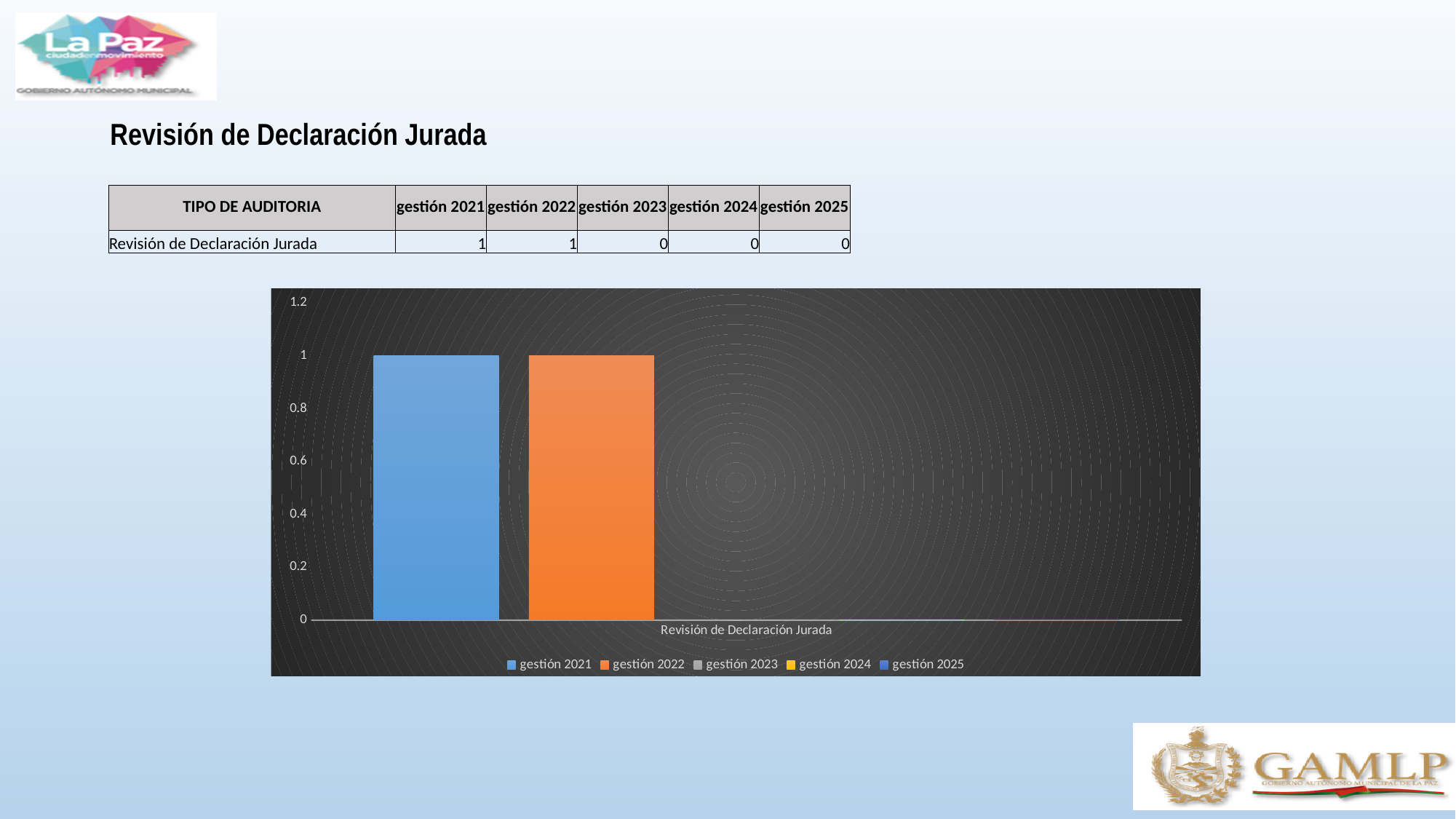
What is the category label shown on the x axis of the chart? Revisión de Declaración Jurada Is the value for gestión 2021 greater or less than 0.8? greater What is the difference between the values for gestión 2021 and gestión 2022? 0 How many series does the chart legend list? 5 How many categories are shown on the x axis of the chart? 1 What colour is the bar for gestión 2022 in the chart? orange What is the value for gestión 2022 in the chart? 1 What kind of chart is shown on the slide? bar chart What is the value for gestión 2023 in the chart? 0 Which is larger, the value for gestión 2022 or the value for gestión 2024? gestión 2022 What is the value for gestión 2025 in the chart? 0 What is the value for gestión 2021 in the chart? 1